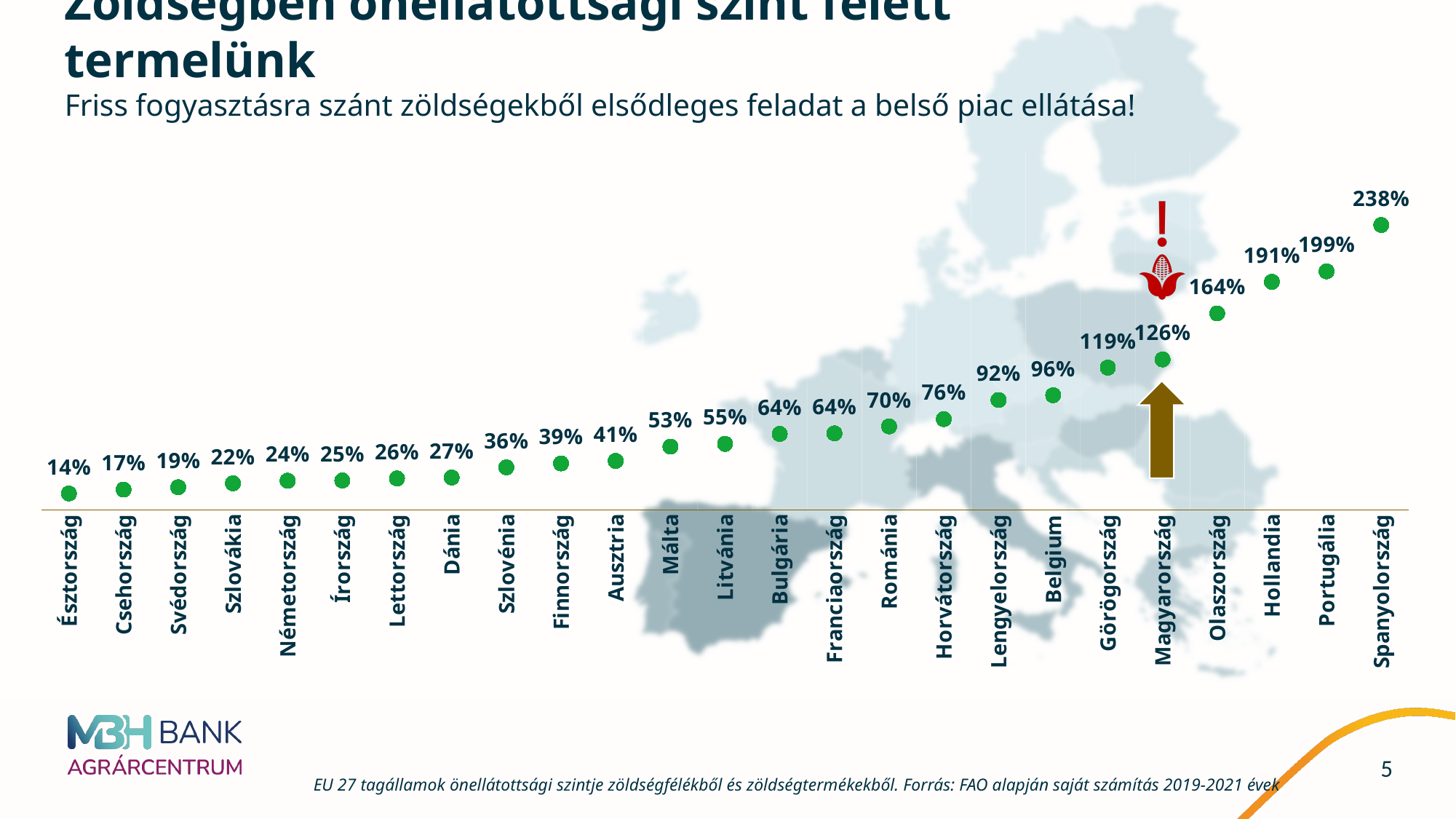
What is the difference between the values for Olaszország and Görögország? 45% What is the value for Magyarország? 126% Do the values rise or fall from left to right along the x axis? Rise How many countries are plotted on the chart? 25 What is the difference between the values for Spanyolország and Magyarország? 112% What is the value for Hollandia? 191% Which country has the lowest value? Észtország What kind of chart is shown on the slide? Dot (scatter) chart Which country is marked with the brown arrow below the chart? Magyarország What is the value for Lengyelország? 92% Which country has the highest value? Spanyolország Which is larger, the value for Belgium or the value for Horvátország? Belgium